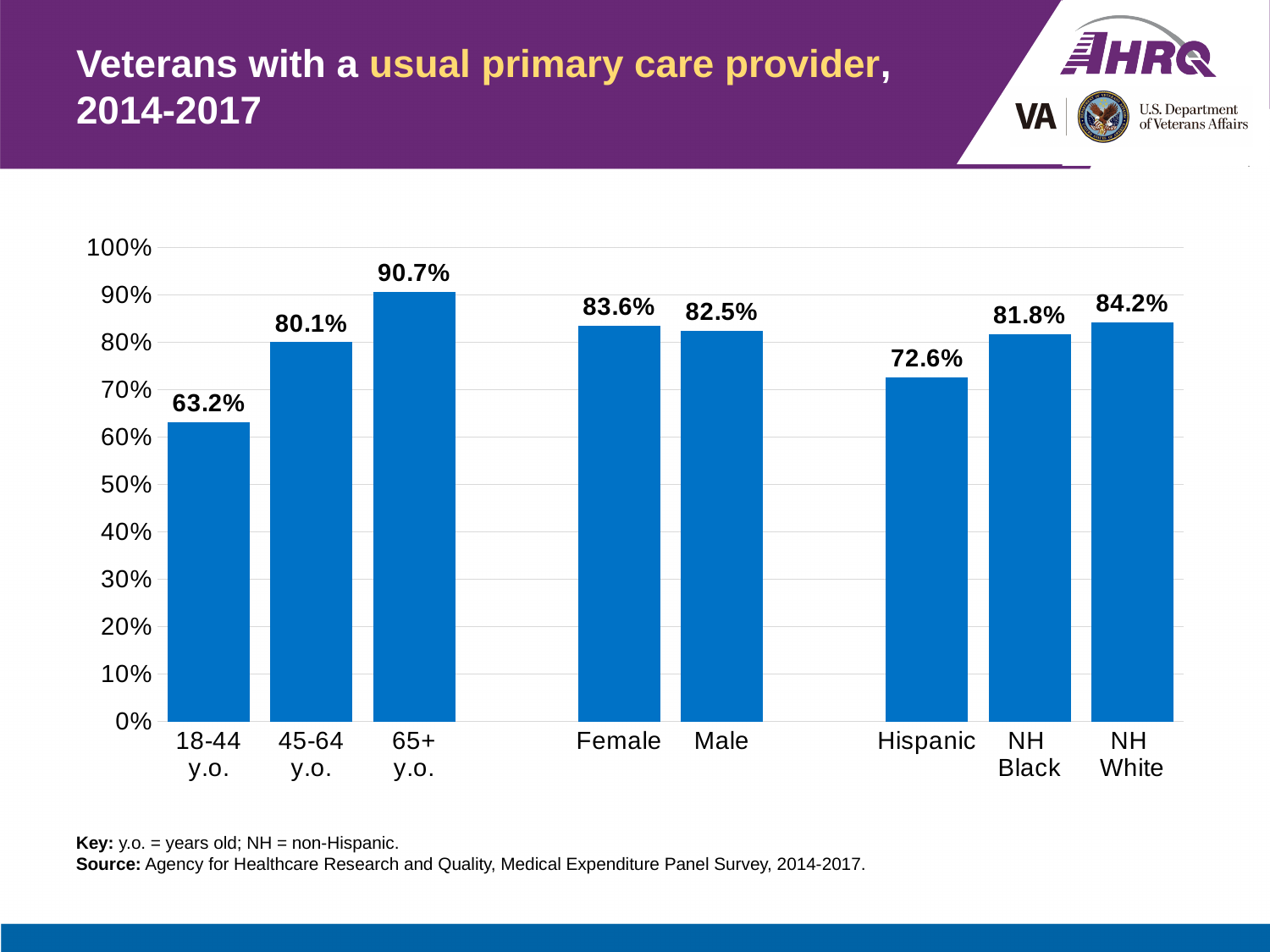
How many categories are shown on the x axis of the chart? 8 Which category has the lowest percentage of veterans with a usual primary care provider? 18-44 y.o. Which is larger, the value for Female or the value for Male veterans? Female Which category has the highest percentage of veterans with a usual primary care provider? 65+ y.o. What percentage of veterans aged 18-44 y.o. had a usual primary care provider? 63.2% What kind of chart is shown on the slide? Bar chart What is the value shown for Hispanic veterans? 72.6% Is the value for 45-64 y.o. veterans greater or less than 70%? greater Do the values rise or fall across the three age groups from 18-44 y.o. to 65+ y.o.? Rise What is the difference between the values for NH White and Hispanic veterans? 11.6% What is the difference between the values for 65+ y.o. and 18-44 y.o. veterans? 27.5% What is the value shown for NH White veterans? 84.2%